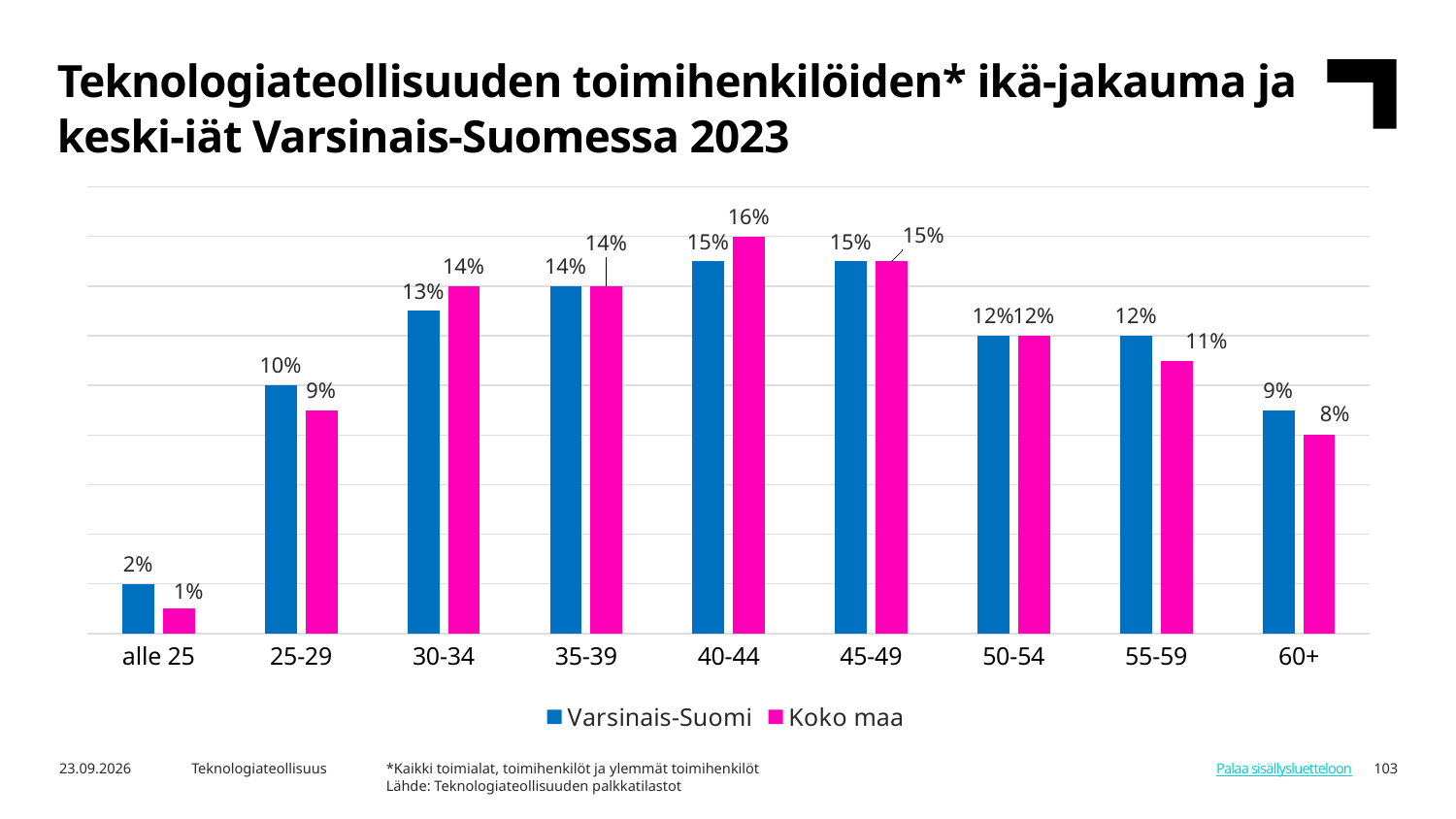
In the 25-29 age group, which series has the larger value, Varsinais-Suomi or Koko maa? Varsinais-Suomi How many series does the legend list? 2 Which age group has the highest value for Koko maa? 40-44 Which colour represents the Koko maa series? pink Which age group has the lowest value for Varsinais-Suomi? alle 25 What is the value for Varsinais-Suomi in the 30-34 age group? 13% Do the Varsinais-Suomi values rise or fall from the 45-49 age group to the 60+ age group? fall What kind of chart is shown on the slide? bar chart What is the value for Koko maa in the 60+ age group? 8% What is the difference between the Varsinais-Suomi and Koko maa values in the 55-59 age group? 1% How many age groups are shown on the x axis? 9 What is the value for Koko maa in the 40-44 age group? 16%